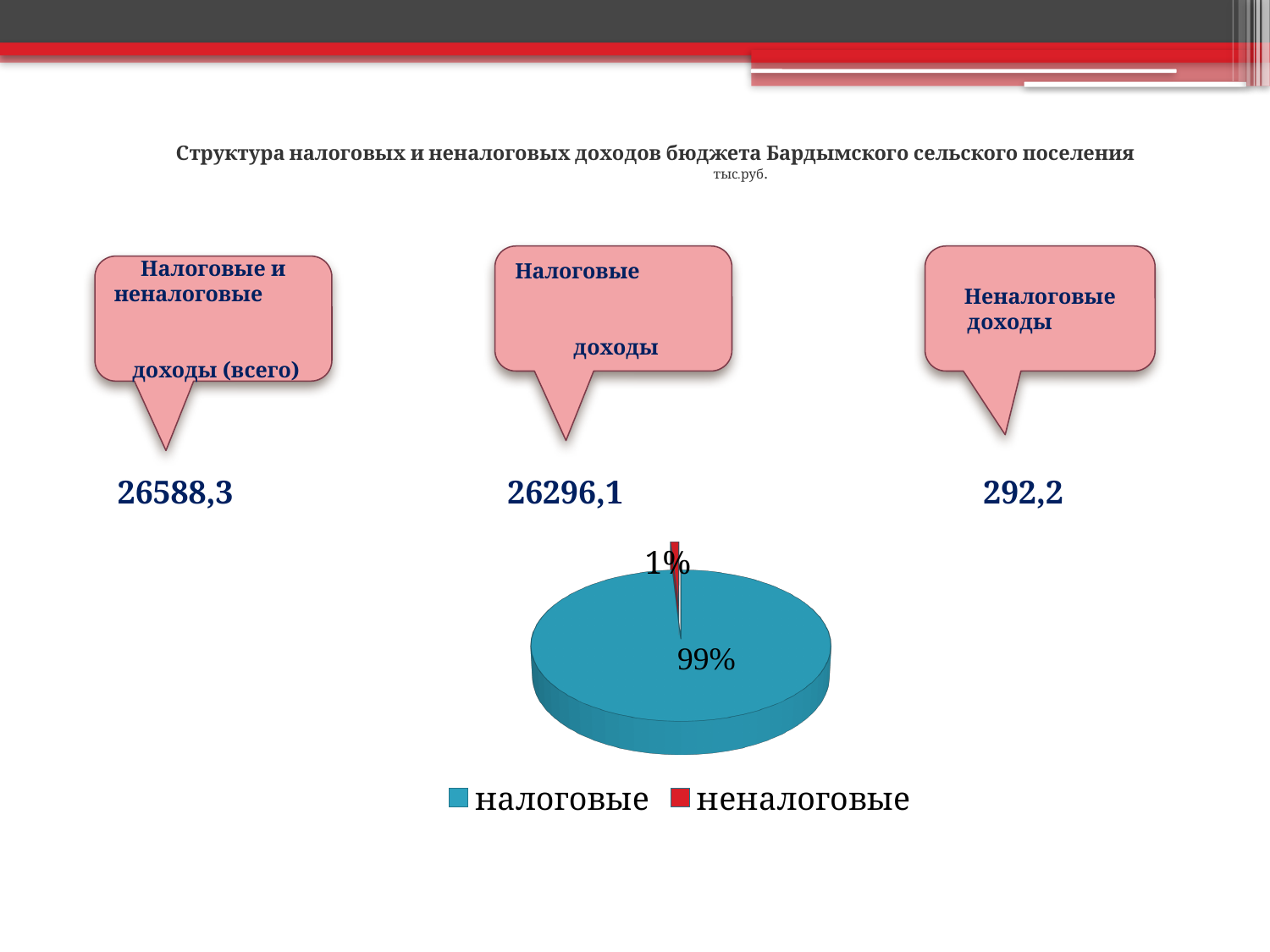
Which is larger in the pie chart, налоговые or неналоговые? налоговые What colour is the неналоговые slice in the pie chart? red Which slice of the pie chart is the largest? налоговые What share of the pie does the налоговые slice represent? 99% How many entries does the legend of the pie chart list? 2 What kind of chart is shown on the slide? pie chart Which slice of the pie chart is the smallest? неналоговые What share of the pie does the неналоговые slice represent? 1% What colour is the налоговые slice in the pie chart? blue How many slices does the pie chart have? 2 What is the difference in percentage points between the налоговые and неналоговые slices? 98